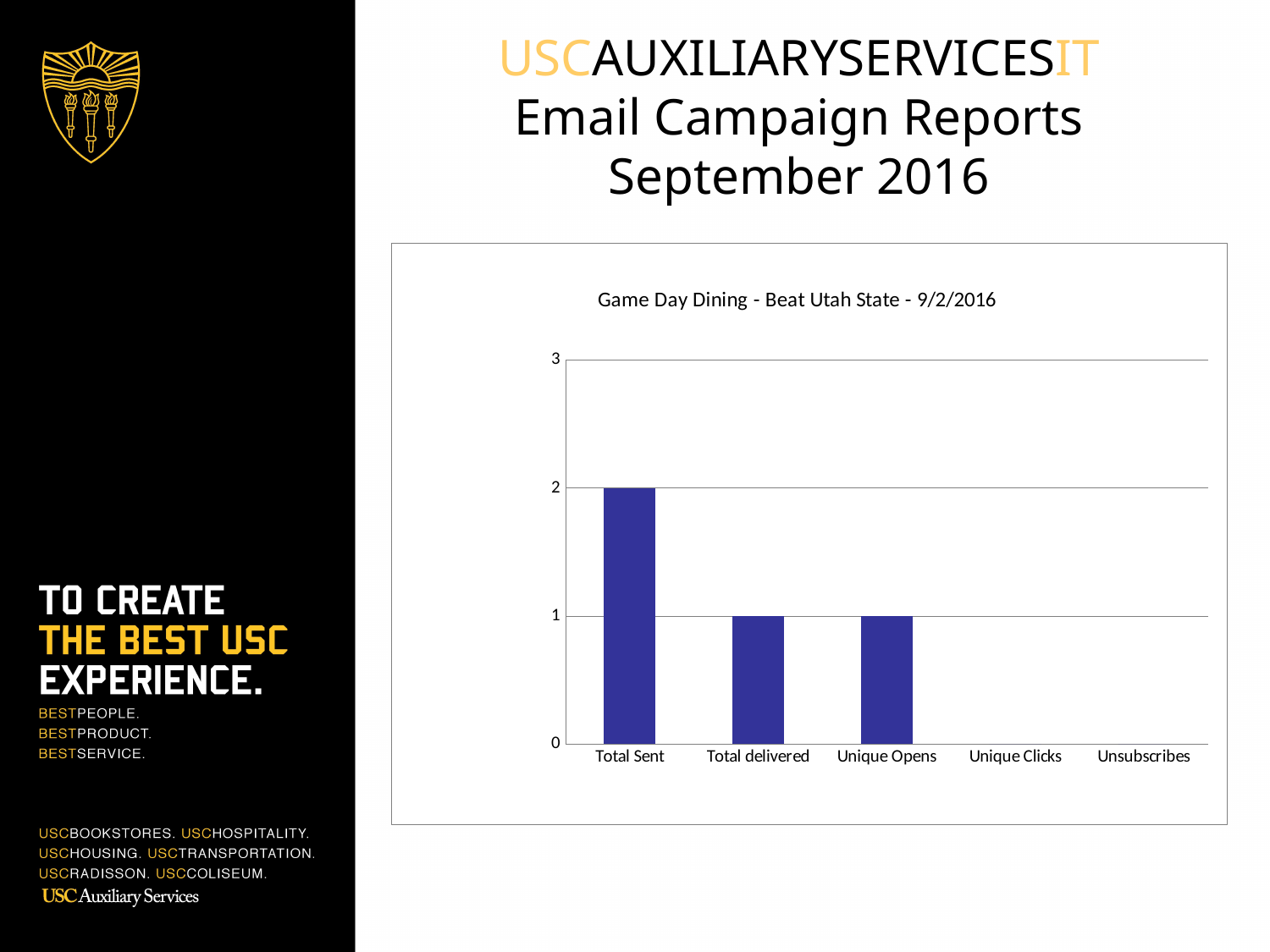
Is the value for Total Sent greater or less than 1? greater How many categories are shown on the x axis? 5 What is the value for Unique Opens? 1 Which is larger, Total Sent or Unique Opens? Total Sent What is the value for Total delivered? 1 What is the value for Total Sent? 2 What is the difference between Total Sent and Total delivered? 1 Which category has the highest value? Total Sent What is the value for Unique Clicks? 0 What is the title of the chart? Game Day Dining - Beat Utah State - 9/2/2016 Do the values rise or fall from Total Sent to Unsubscribes along the x axis? fall What kind of chart is shown on the slide? bar chart